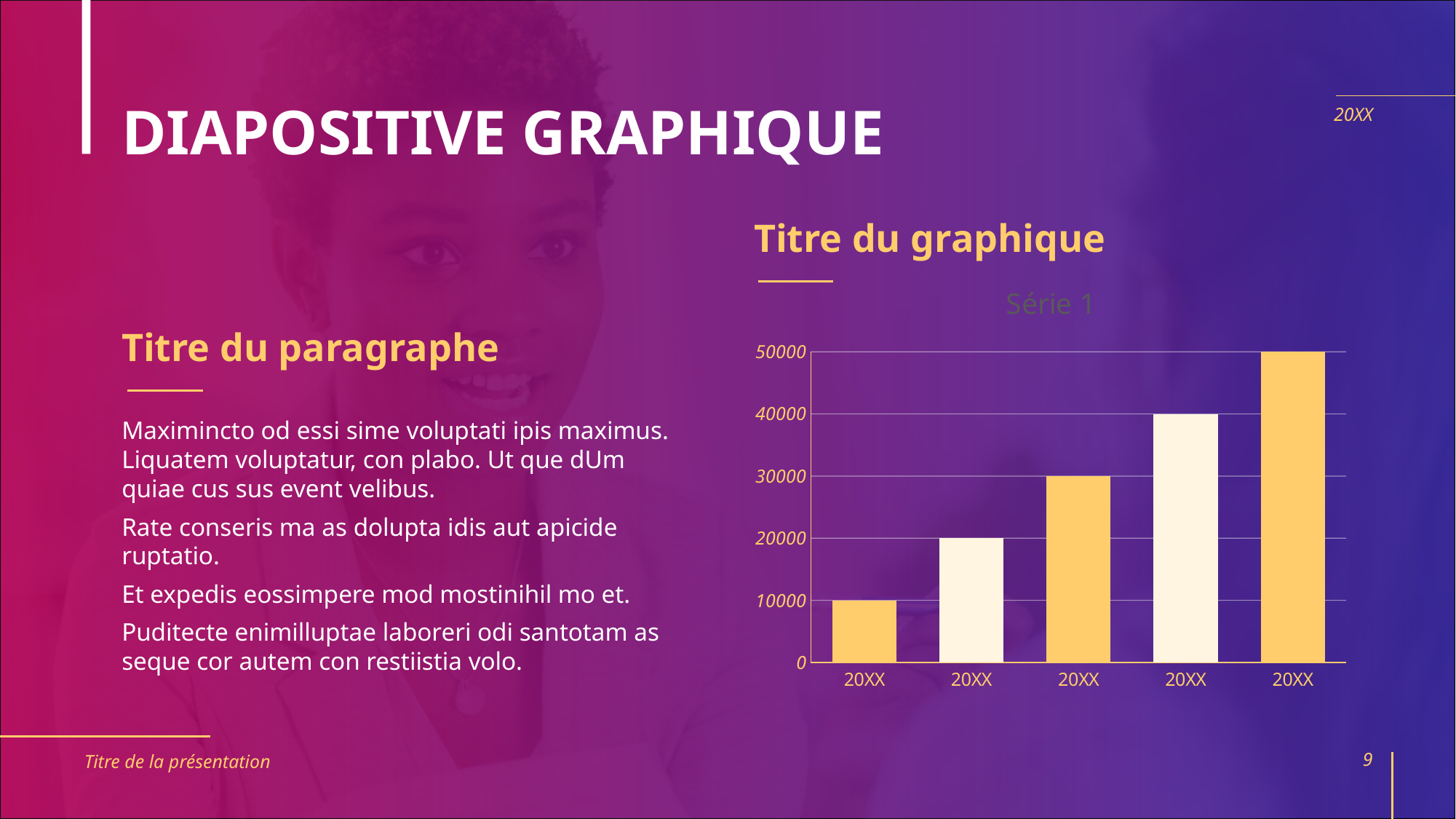
What is the value of the first (leftmost) bar? 10000 Which bar is the tallest? the rightmost (fifth) bar What kind of chart is shown on the slide? bar chart Do the bar values rise or fall from left to right along the x axis? rise What is the value of the third bar from the left? 30000 What is the value of the last (rightmost) bar? 50000 Which bar is the shortest? the leftmost (first) bar How many bars does the chart have? 5 What is the series name shown above the chart? Série 1 Which is larger, the second bar or the fourth bar? the fourth bar What is the highest value shown on the vertical axis? 50000 What is the difference between the fourth bar and the second bar? 20000